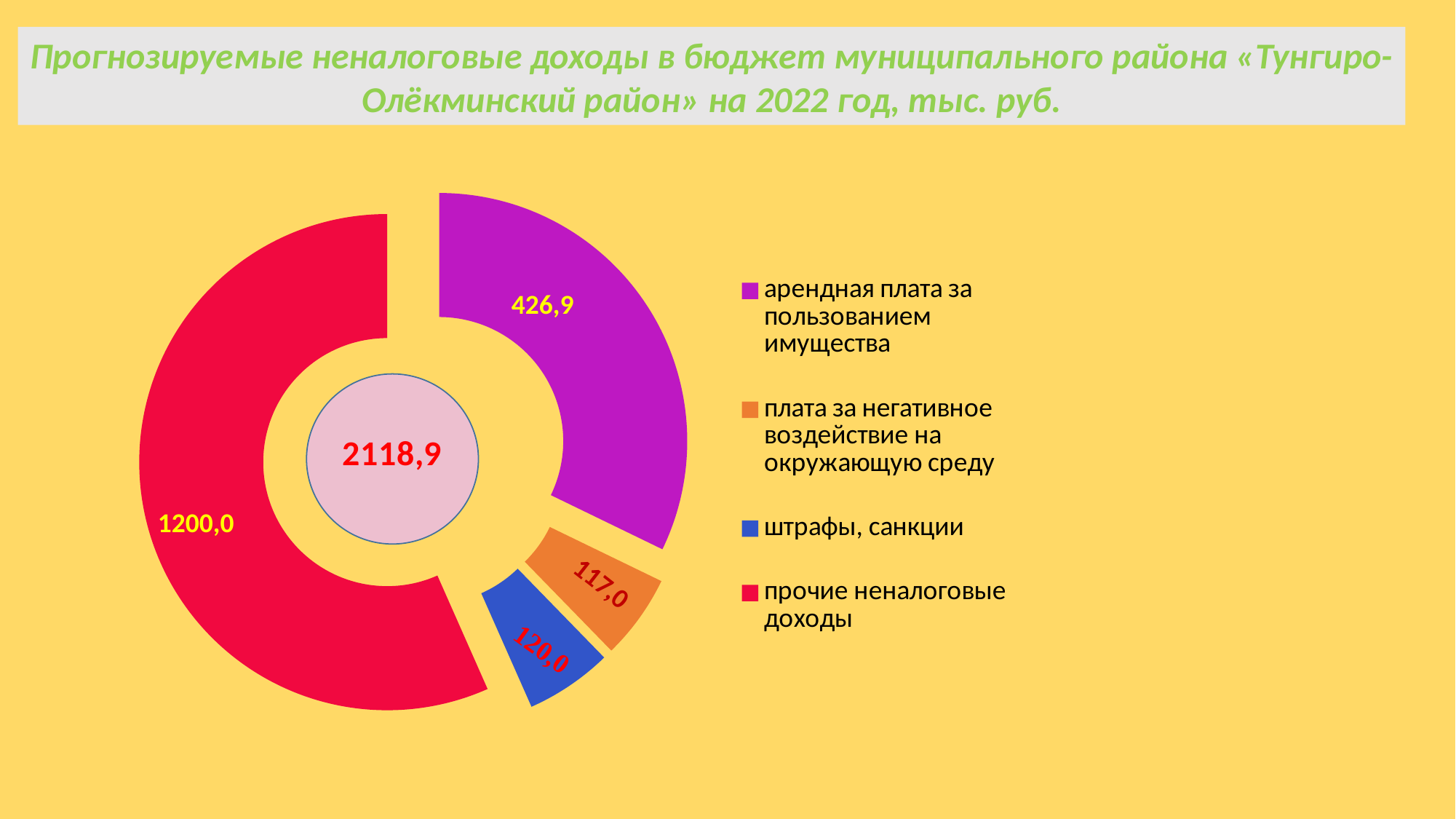
Which category has the largest value? прочие неналоговые доходы What kind of chart is shown on the slide? doughnut chart What is the value for «прочие неналоговые доходы»? 1200,0 What is the difference between «штрафы, санкции» and «плата за негативное воздействие на окружающую среду»? 3,0 What is the value for «плата за негативное воздействие на окружающую среду»? 117,0 Which is larger: «штрафы, санкции» or «плата за негативное воздействие на окружающую среду»? штрафы, санкции How many categories does the chart show? 4 What is the difference between «прочие неналоговые доходы» and «арендная плата за пользованием имущества»? 773,1 What number is printed in the centre of the chart? 2118,9 What is the value for «арендная плата за пользованием имущества»? 426,9 What is the value for «штрафы, санкции»? 120,0 Which category has the smallest value? плата за негативное воздействие на окружающую среду